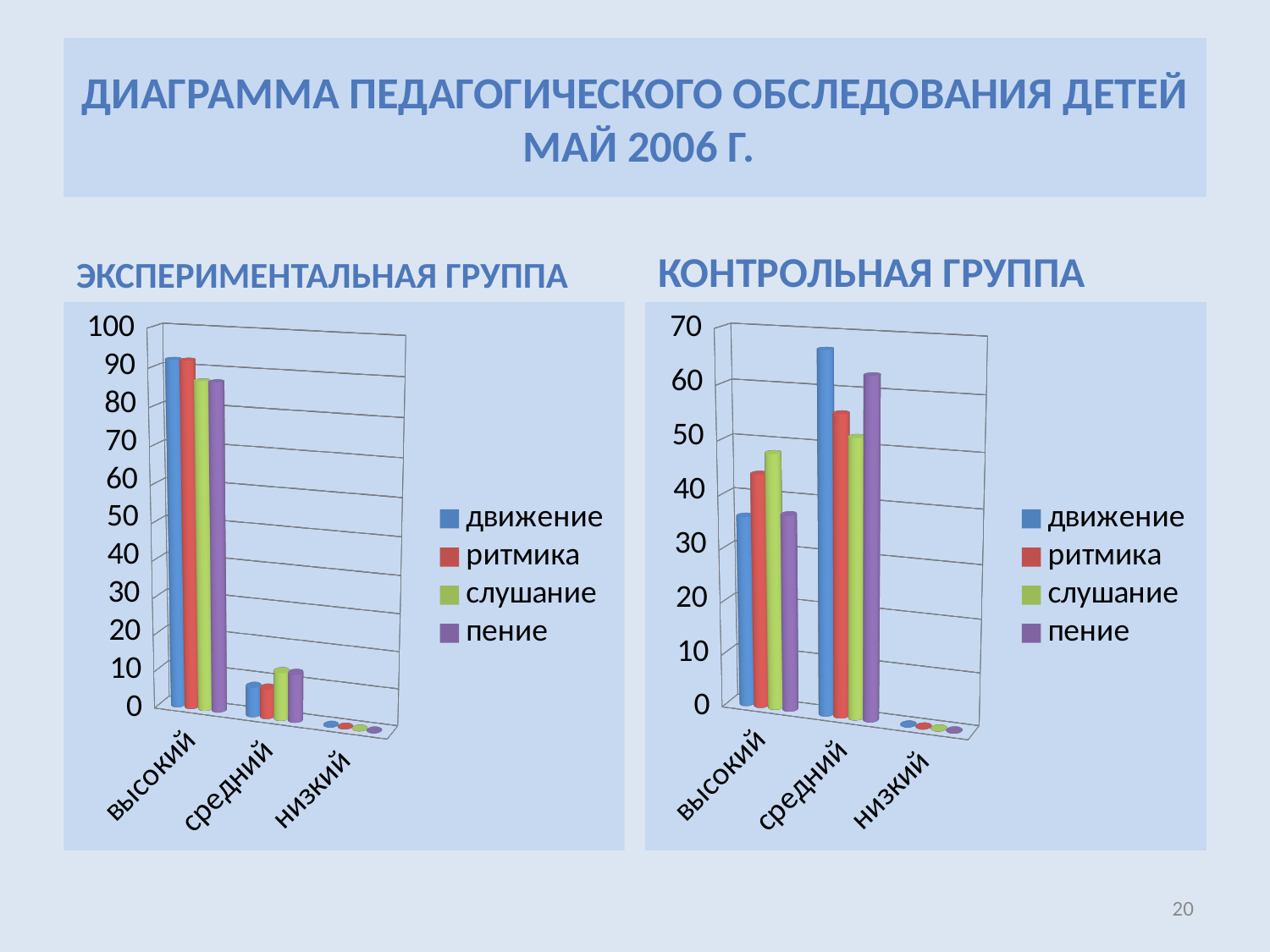
In the ЭКСПЕРИМЕНТАЛЬНАЯ ГРУППА chart, is the value of слушание for средний greater or less than 20? less In the КОНТРОЛЬНАЯ ГРУППА chart, which is larger for высокий: слушание or движение? слушание In the ЭКСПЕРИМЕНТАЛЬНАЯ ГРУППА chart, which category has the lowest values across all series? низкий What kind of chart is the ЭКСПЕРИМЕНТАЛЬНАЯ ГРУППА chart on the left? bar chart In the ЭКСПЕРИМЕНТАЛЬНАЯ ГРУППА chart, is the value of движение for высокий greater or less than 80? greater How many categories are shown on the x axis of the КОНТРОЛЬНАЯ ГРУППА chart on the right? 3 In the КОНТРОЛЬНАЯ ГРУППА chart, is the value of движение for средний greater or less than 60? greater In the ЭКСПЕРИМЕНТАЛЬНАЯ ГРУППА chart, which category has the highest values across all series? высокий How many series does the legend of the ЭКСПЕРИМЕНТАЛЬНАЯ ГРУППА chart list? 4 In the КОНТРОЛЬНАЯ ГРУППА chart, which series has the highest value for the средний category? движение What is the title of the chart on the right side of the slide? КОНТРОЛЬНАЯ ГРУППА